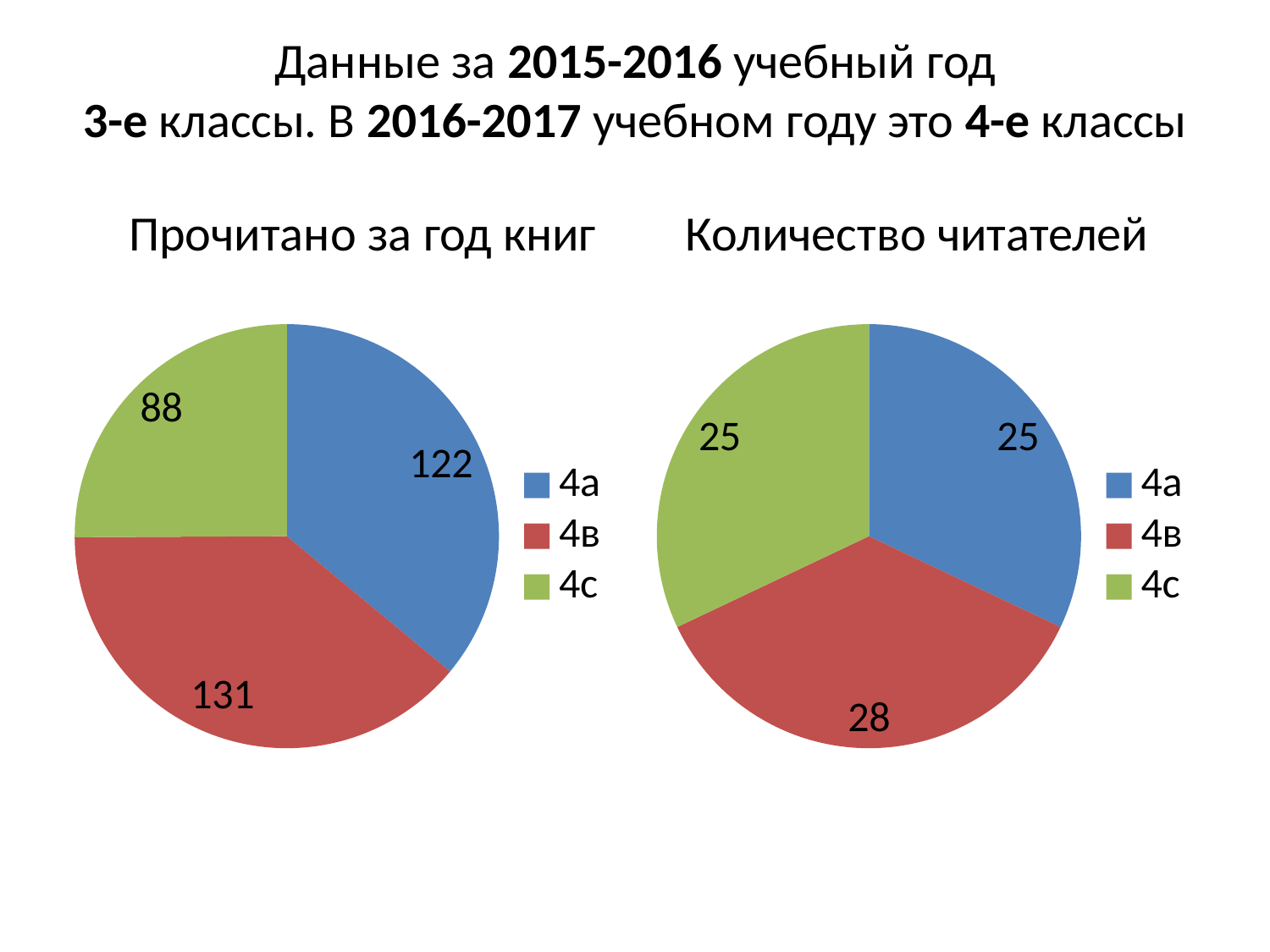
In the chart titled 'Прочитано за год книг', what is the difference between the values for 4в and 4а? 9 How many slices does the chart titled 'Количество читателей' have? 3 In the chart titled 'Количество читателей', which class has the largest slice? 4в In the chart titled 'Прочитано за год книг', what is the value for class 4с? 88 In the chart titled 'Количество читателей', what is the value for class 4в? 28 In the chart titled 'Прочитано за год книг', which class has the largest slice? 4в In the chart titled 'Количество читателей', what is the difference between the values for 4в and 4с? 3 What type of chart is the chart titled 'Прочитано за год книг'? Pie chart In the chart titled 'Прочитано за год книг', how many books did class 4в read? 131 In the chart titled 'Количество читателей', what colour is the slice for class 4с? Green In the chart titled 'Прочитано за год книг', which class has the smallest slice? 4с In the chart titled 'Прочитано за год книг', which is larger: the value for 4а or the value for 4с? 4а